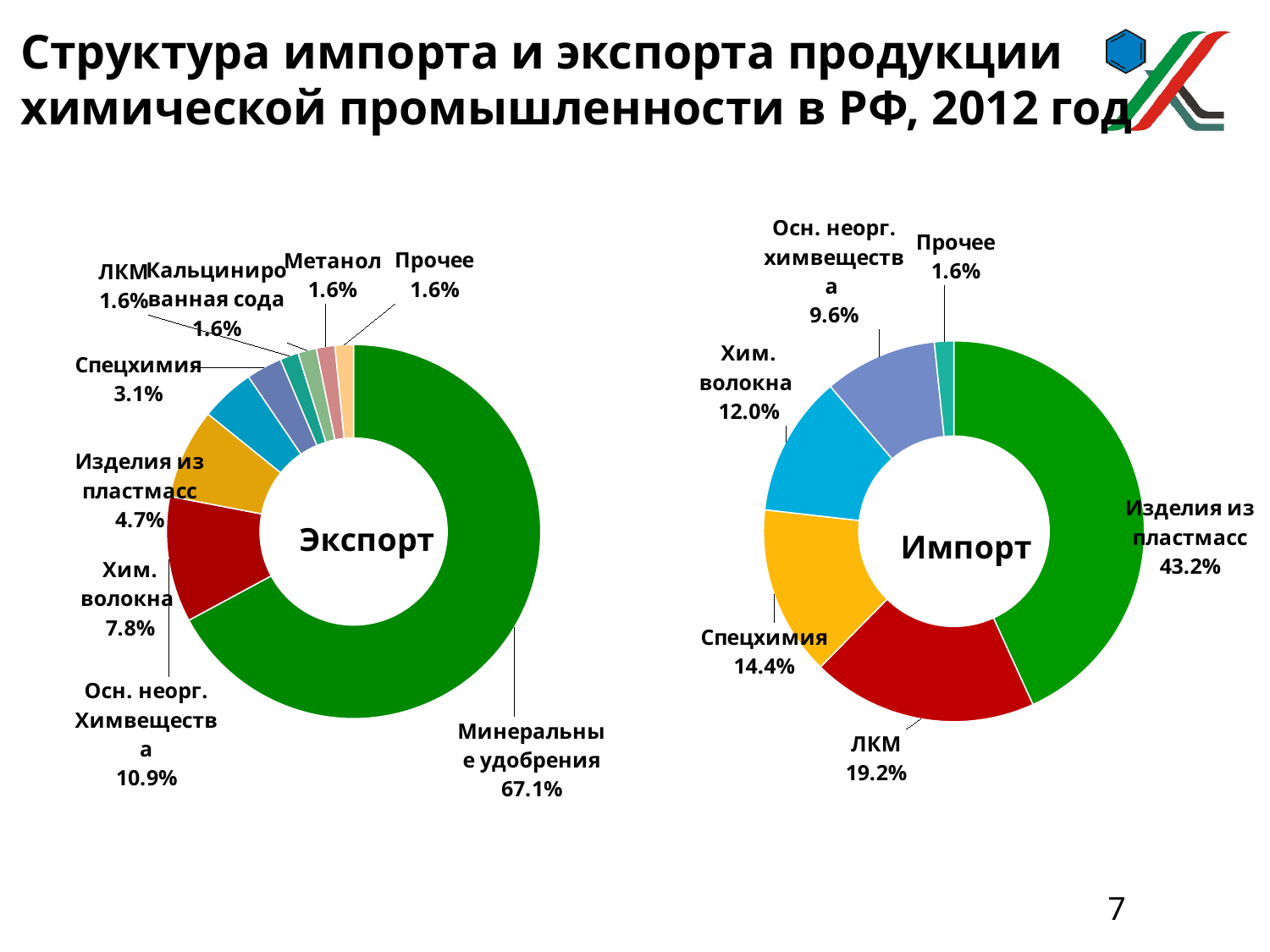
In the "Импорт" chart, what is the share of ЛКМ? 19.2% In the "Экспорт" chart, which category has the largest share? Минеральные удобрения In the "Экспорт" chart, what is the difference between the shares of Осн. неорг. Химвещества and Хим. волокна? 3.1% Which is larger: the share of Спецхимия in the "Импорт" chart or in the "Экспорт" chart? Импорт In the "Экспорт" chart, what is the share of Хим. волокна? 7.8% How many categories are shown in the "Импорт" chart? 6 What type of chart is the "Экспорт" chart? Pie (donut) chart In the "Импорт" chart, what is the difference between the shares of Изделия из пластмасс and ЛКМ? 24.0% In the "Импорт" chart, which category has the largest share? Изделия из пластмасс In the "Импорт" chart, which category has the smallest share? Прочее In the "Экспорт" chart, what share do Минеральные удобрения have? 67.1% In the "Импорт" chart, what share do Изделия из пластмасс have? 43.2%